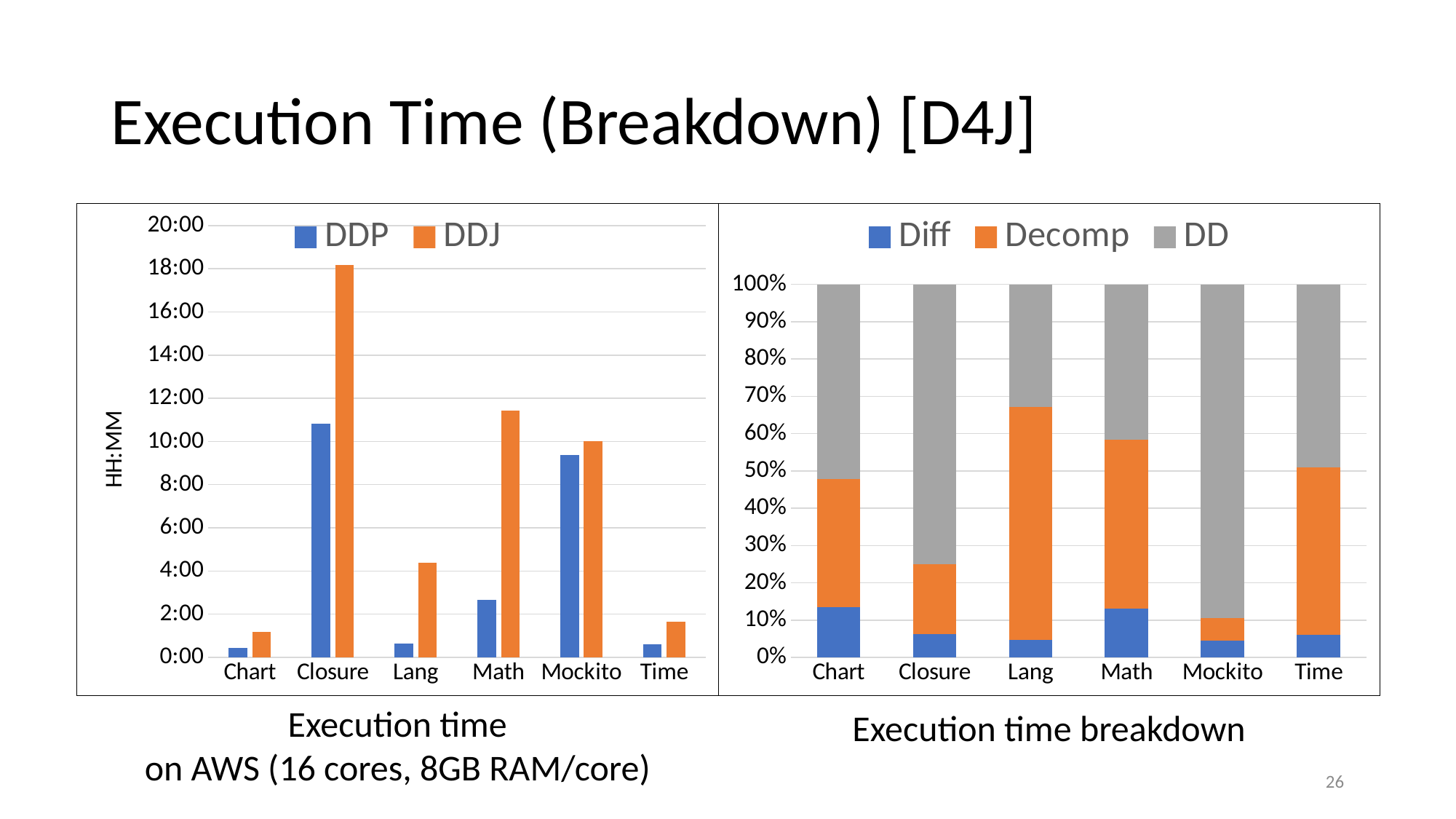
On the right chart (Execution time breakdown), which project has the largest Decomp share? Lang On the right chart (Execution time breakdown), how many series does the legend list? 3 On the left chart (Execution time on AWS), how many series does the legend list? 2 On the left chart (Execution time on AWS), is the DDJ value for Closure greater or less than 16:00? greater On the left chart (Execution time on AWS), which project has the highest DDJ execution time? Closure On the left chart (Execution time on AWS), is the DDP value for Closure greater or less than 10:00? greater On the left chart (Execution time on AWS), which is larger for Math, the DDP value or the DDJ value? DDJ On the left chart (Execution time on AWS), is the DDJ value for Lang greater or less than 6:00? less On the left chart (Execution time on AWS), how many projects are shown on the x axis? 6 On the right chart (Execution time breakdown), which project has the largest DD share? Mockito What kind of chart is the right chart (Execution time breakdown)? Stacked bar chart